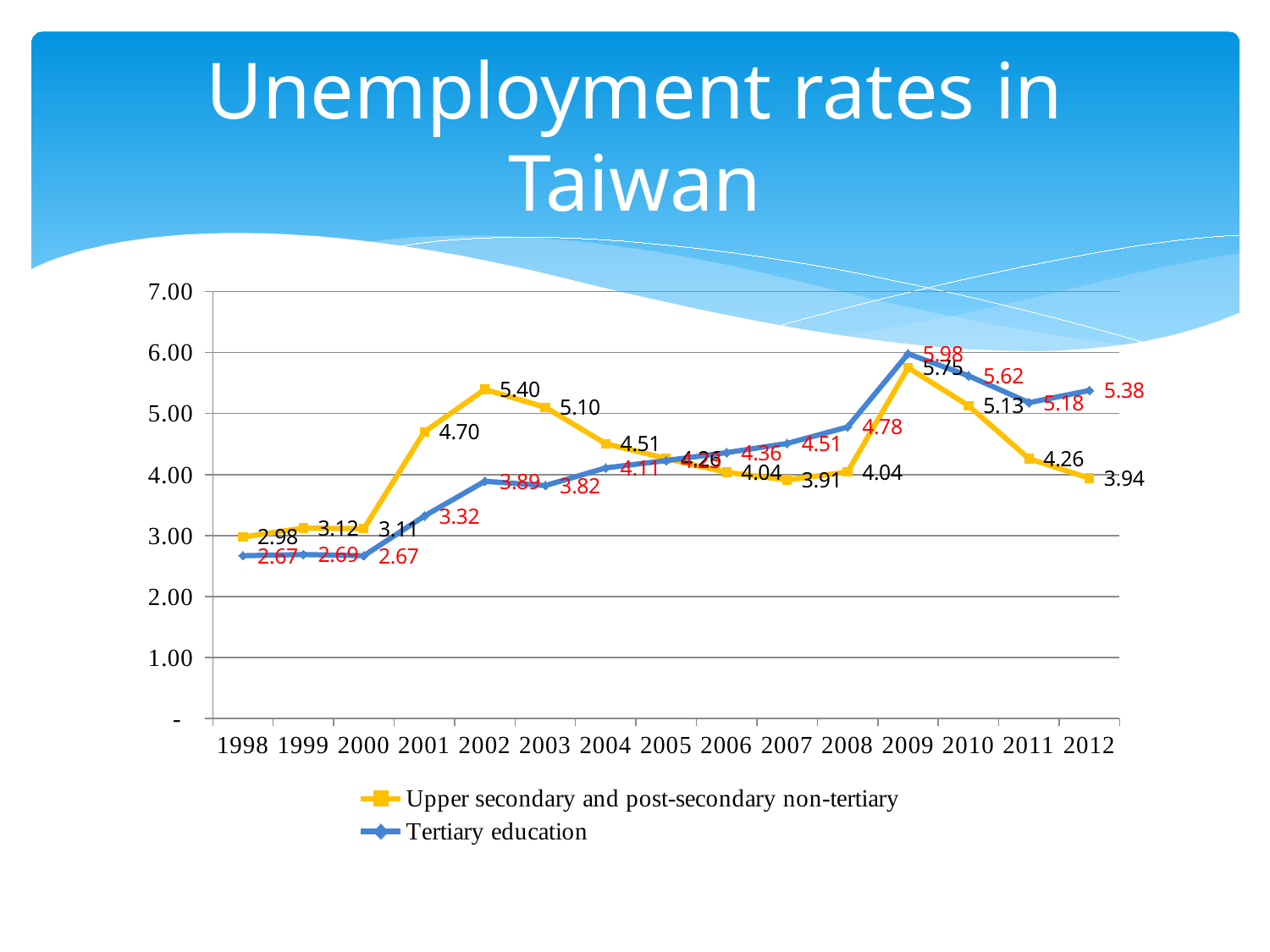
Which series has the higher unemployment rate in 2002? Upper secondary and post-secondary non-tertiary In which year is the Upper secondary and post-secondary non-tertiary unemployment rate lowest? 1998 How many years are plotted along the x axis? 15 What is the unemployment rate for Upper secondary and post-secondary non-tertiary in 2002? 5.40 What is the unemployment rate for Tertiary education in 2012? 5.38 In 2012, how much higher is the Tertiary education rate than the Upper secondary and post-secondary non-tertiary rate? 1.44 What is the unemployment rate for Upper secondary and post-secondary non-tertiary in 2007? 3.91 Does the Tertiary education unemployment rate rise or fall from 1998 to 2009? Rise What kind of chart is shown on the slide? Line chart How many series does the legend list? 2 In which year is the Tertiary education unemployment rate highest? 2009 In 2001, what is the difference between the Upper secondary and post-secondary non-tertiary rate and the Tertiary education rate? 1.38